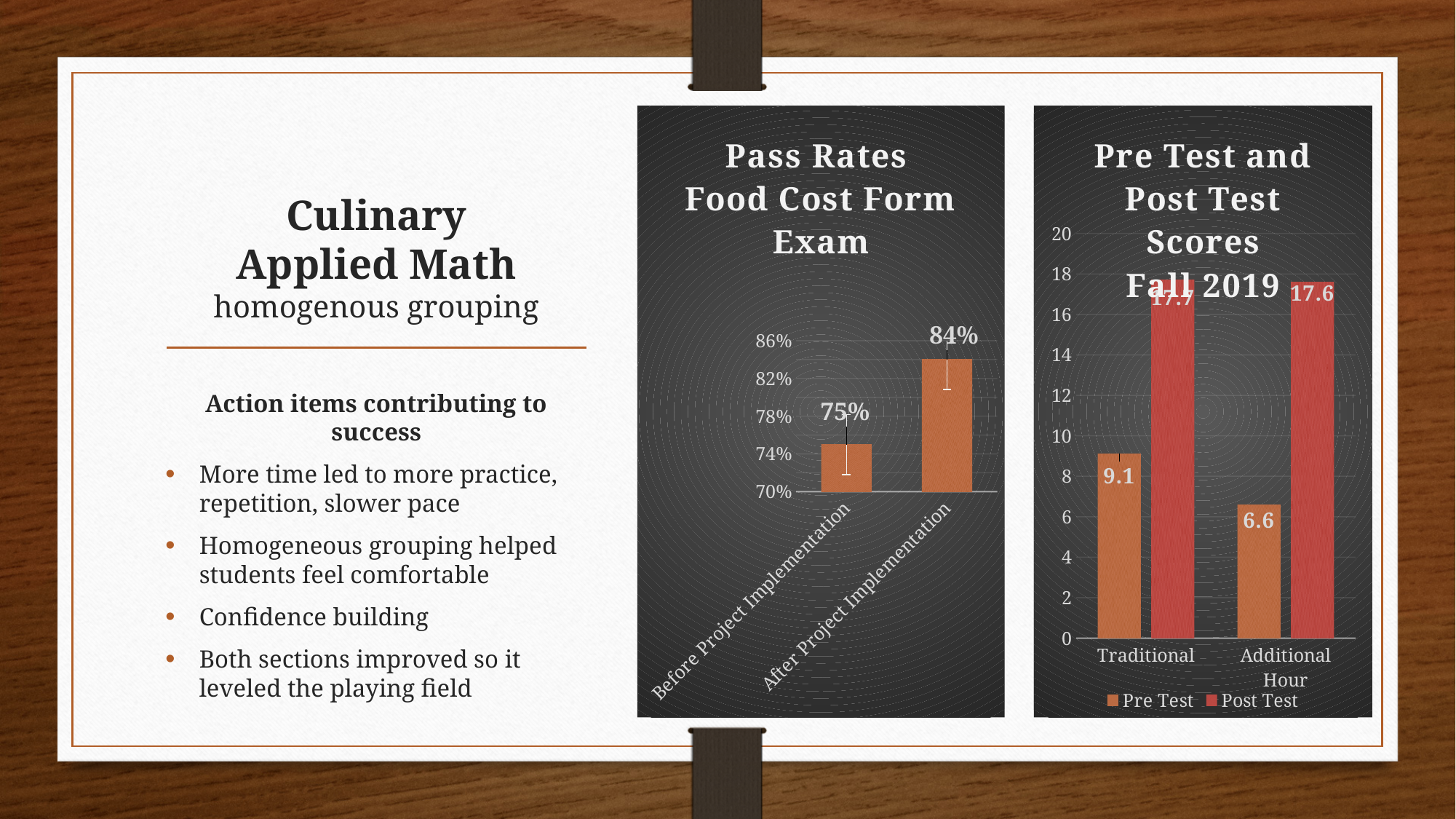
In the Pre Test and Post Test Scores Fall 2019 chart, what is the difference between the Post Test and Pre Test scores for Traditional? 8.6 In the Pre Test and Post Test Scores Fall 2019 chart, what is the Post Test score for Additional Hour? 17.6 In the Pass Rates Food Cost Form Exam chart, how many categories are plotted? 2 In the Pre Test and Post Test Scores Fall 2019 chart, is the Pre Test score for Additional Hour greater or less than 8? less In the Pass Rates Food Cost Form Exam chart, what is the pass rate before project implementation? 75% In the Pre Test and Post Test Scores Fall 2019 chart, what is the Pre Test score for Traditional? 9.1 In the Pass Rates Food Cost Form Exam chart, by how many percentage points did the pass rate increase from before to after project implementation? 9 percentage points In the Pre Test and Post Test Scores Fall 2019 chart, how many series does the legend list? 2 In the Pre Test and Post Test Scores Fall 2019 chart, which group has the lower Pre Test score? Additional Hour What kind of chart is the Pass Rates Food Cost Form Exam chart? Bar chart In the Pass Rates Food Cost Form Exam chart, which category has the higher pass rate? After Project Implementation In the Pass Rates Food Cost Form Exam chart, what is the pass rate after project implementation? 84%